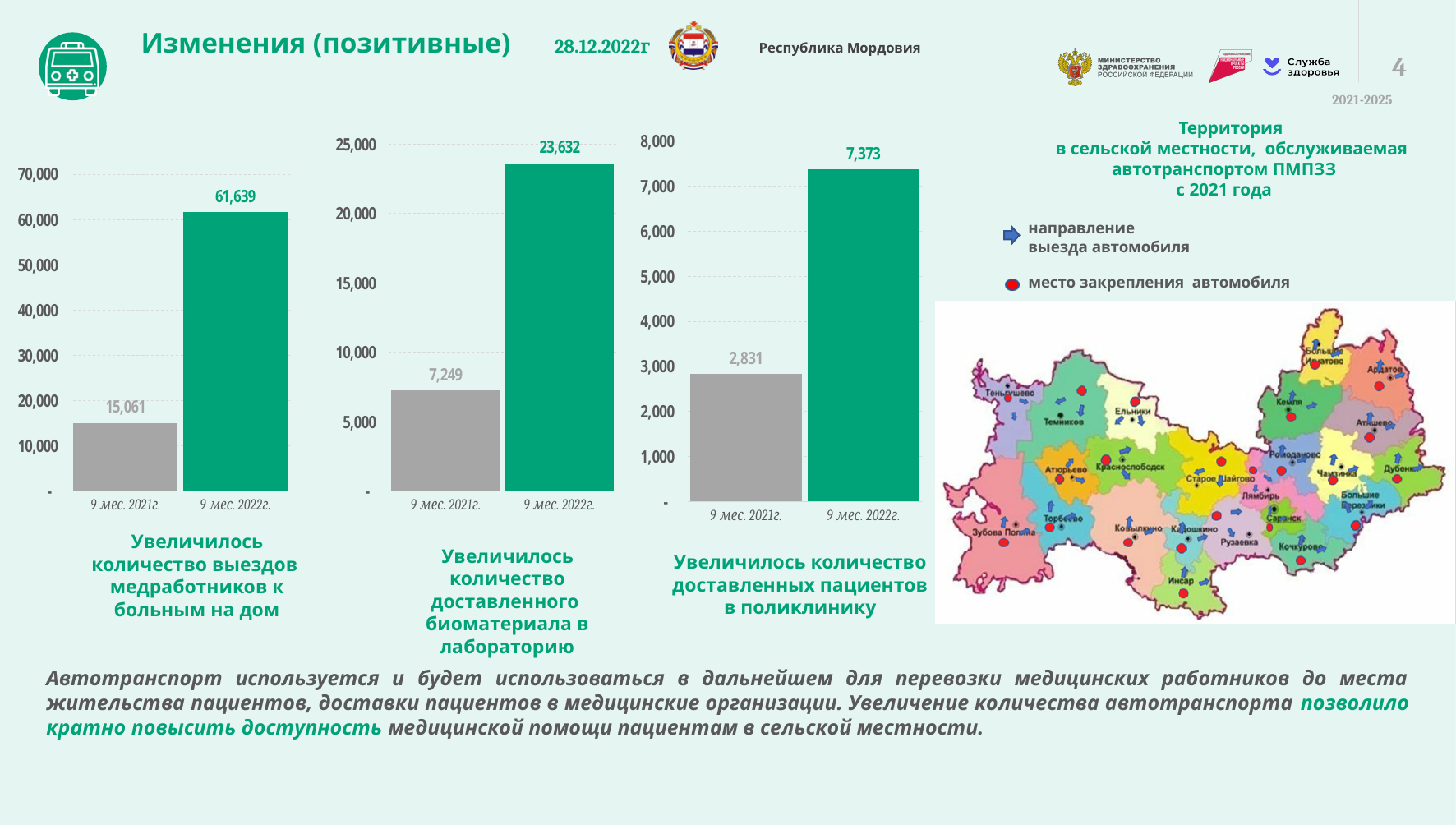
In the middle chart (доставленный биоматериал в лабораторию), what is the value for 9 мес. 2021г.? 7,249 In the middle chart, what is the difference between the 9 мес. 2022г. and 9 мес. 2021г. values? 16,383 In the right chart, which period has the higher value, 9 мес. 2021г. or 9 мес. 2022г.? 9 мес. 2022г. In the left chart (выезды медработников к больным на дом), what is the value for 9 мес. 2021г.? 15,061 In the right chart (доставленные пациенты в поликлинику), what is the value for 9 мес. 2021г.? 2,831 In the middle chart (доставленный биоматериал в лабораторию), what is the value for 9 мес. 2022г.? 23,632 In the left chart (выезды медработников к больным на дом), what is the value for 9 мес. 2022г.? 61,639 In the left chart, by how much does the value for 9 мес. 2022г. exceed the value for 9 мес. 2021г.? 46,578 How many bars does the left chart contain? 2 In the right chart (доставленные пациенты в поликлинику), what is the value for 9 мес. 2022г.? 7,373 In the right chart, what is the difference between the 9 мес. 2022г. and 9 мес. 2021г. values? 4,542 What type of chart is the middle chart on the slide? Bar chart